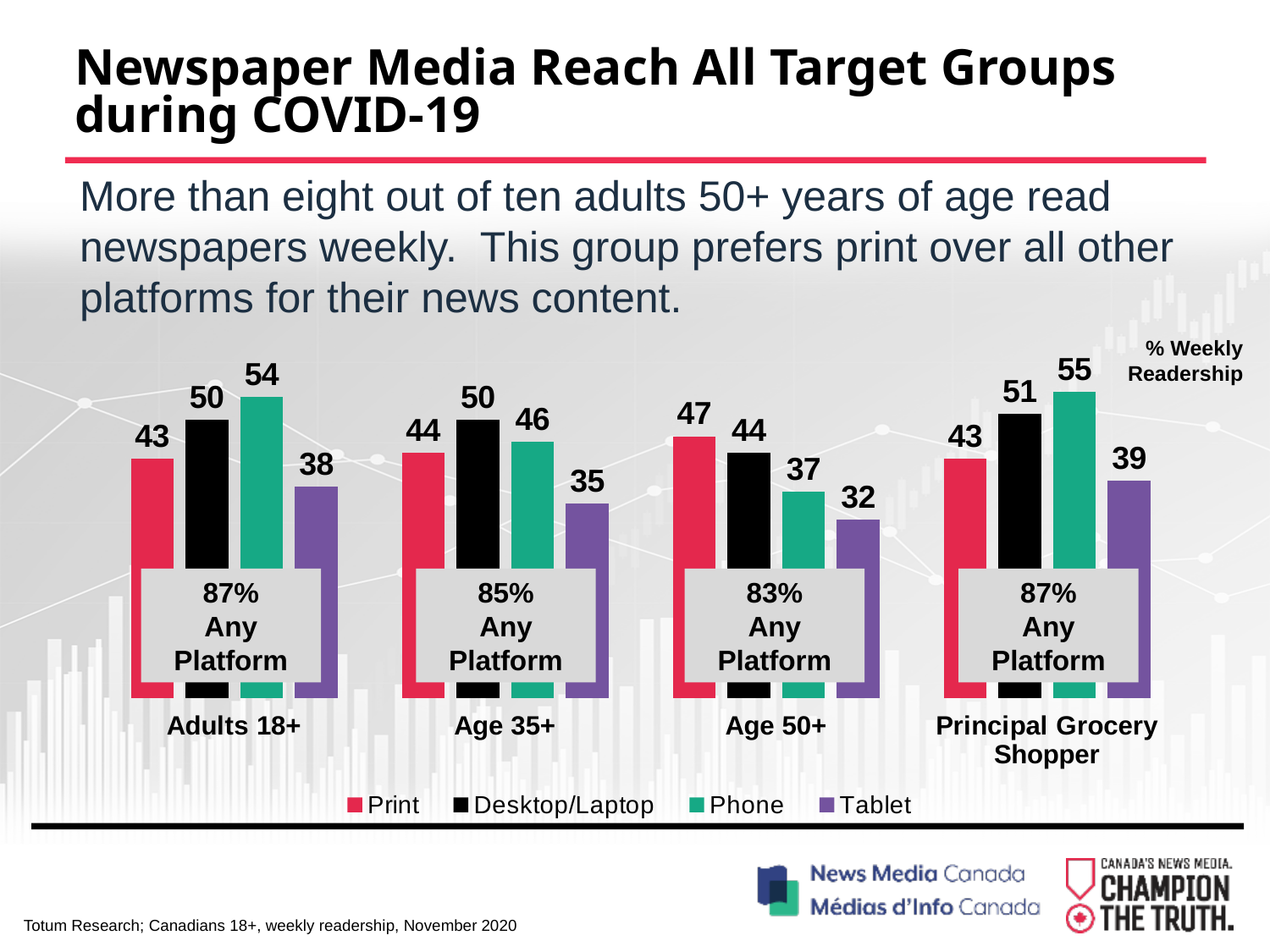
What kind of chart is shown on the slide? Bar chart Which category has the lowest Tablet value? Age 50+ What is the Desktop/Laptop value for Age 35+? 50 What is the 'Any Platform' percentage shown for Age 50+? 83% How many series does the legend list? 4 What is the Tablet value for Adults 18+? 38 Which category has the highest Phone value? Principal Grocery Shopper What is the Print value for Age 50+? 47 What is the Phone value for Principal Grocery Shopper? 55 How many categories are shown on the x axis? 4 For Age 50+, which is larger: the Print value or the Desktop/Laptop value? Print What is the difference between the Phone and Tablet values for Adults 18+? 16